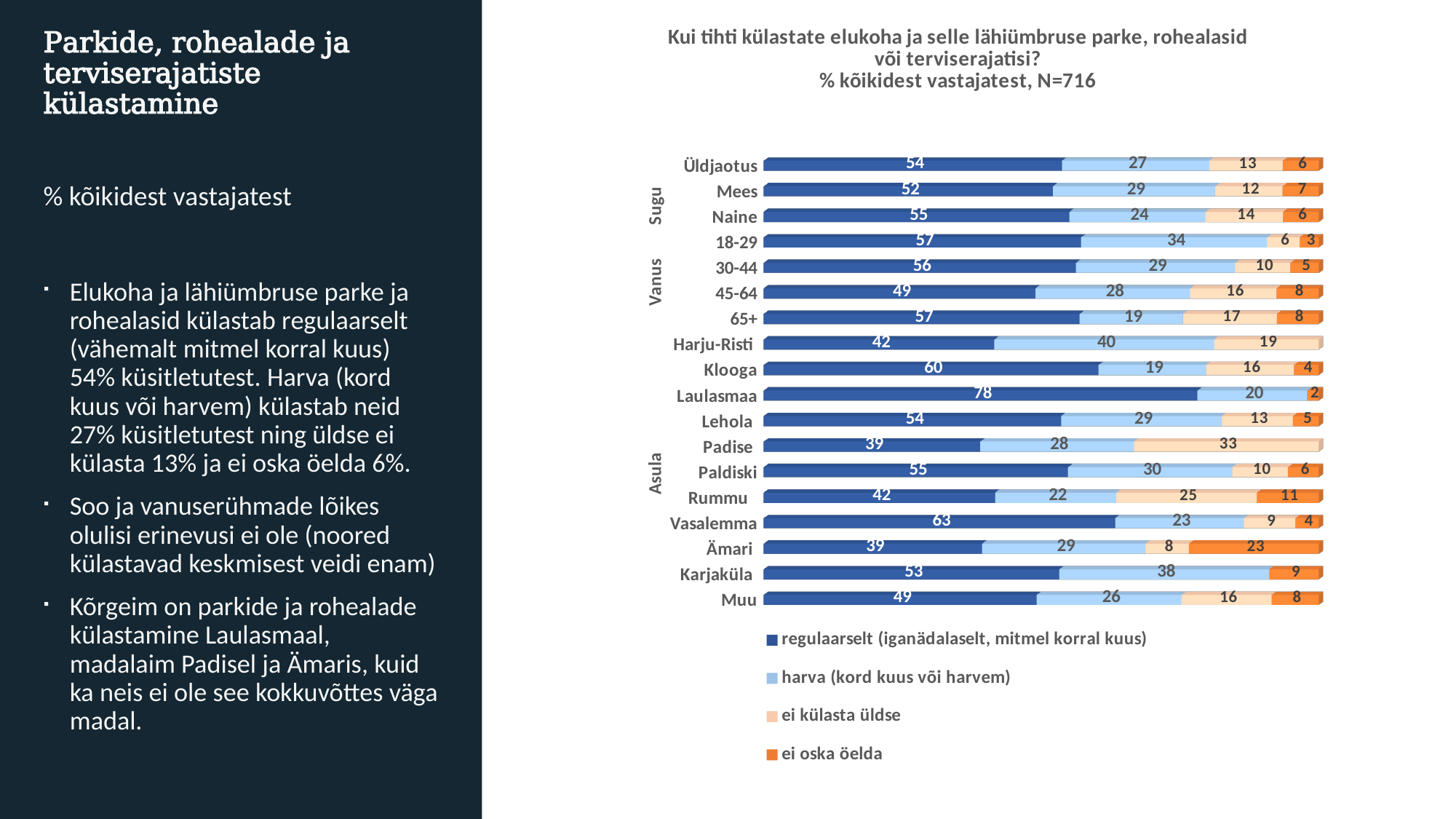
Which category has the highest value for 'regulaarselt'? Laulasmaa Which has a larger 'regulaarselt' value, Klooga or Vasalemma? Vasalemma What is the total of the stacked bar for Mees? 100 How many categories (rows) are plotted in the chart? 18 What type of chart is shown on the slide? stacked bar chart What is the difference between the 'regulaarselt' values for Laulasmaa and Padise? 39 What is the value for 'ei oska öelda' in the Ämari row? 23 What is the value for 'regulaarselt' in the Üldjaotus row? 54 What is the value for 'harva (kord kuus või harvem)' for the 18-29 age group? 34 How many series does the legend list? 4 What is the N (number of respondents) stated in the chart title? 716 Which category has the highest value for 'ei külasta üldse'? Padise